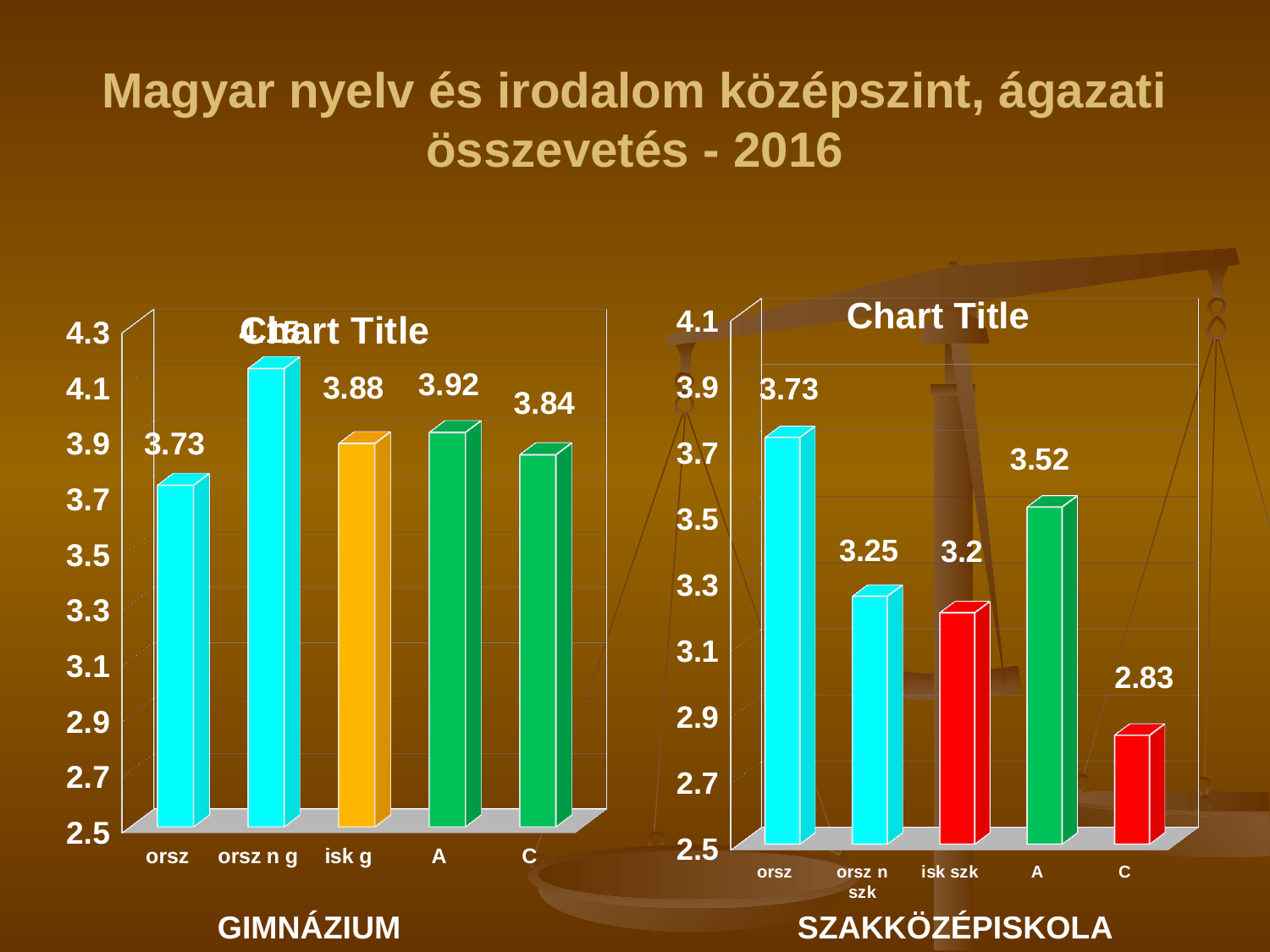
In the left chart (GIMNÁZIUM), what is the value for A? 3.92 In the right chart (SZAKKÖZÉPISKOLA), which category has the lowest value? C In the right chart (SZAKKÖZÉPISKOLA), which category has the highest value? orsz In the right chart (SZAKKÖZÉPISKOLA), what is the value for isk szk? 3.2 In the left chart (GIMNÁZIUM), which category has the highest bar? orsz n g In the right chart (SZAKKÖZÉPISKOLA), what is the value for C? 2.83 In the left chart (GIMNÁZIUM), what is the difference between the values for A and C? 0.08 In the left chart (GIMNÁZIUM), which category has the lowest value? orsz In the left chart (GIMNÁZIUM), how many categories are shown on the x axis? 5 In the right chart (SZAKKÖZÉPISKOLA), what is the difference between the values for orsz and A? 0.21 In the left chart (GIMNÁZIUM), what is the value for orsz? 3.73 What kind of chart is the right chart (SZAKKÖZÉPISKOLA)? bar chart